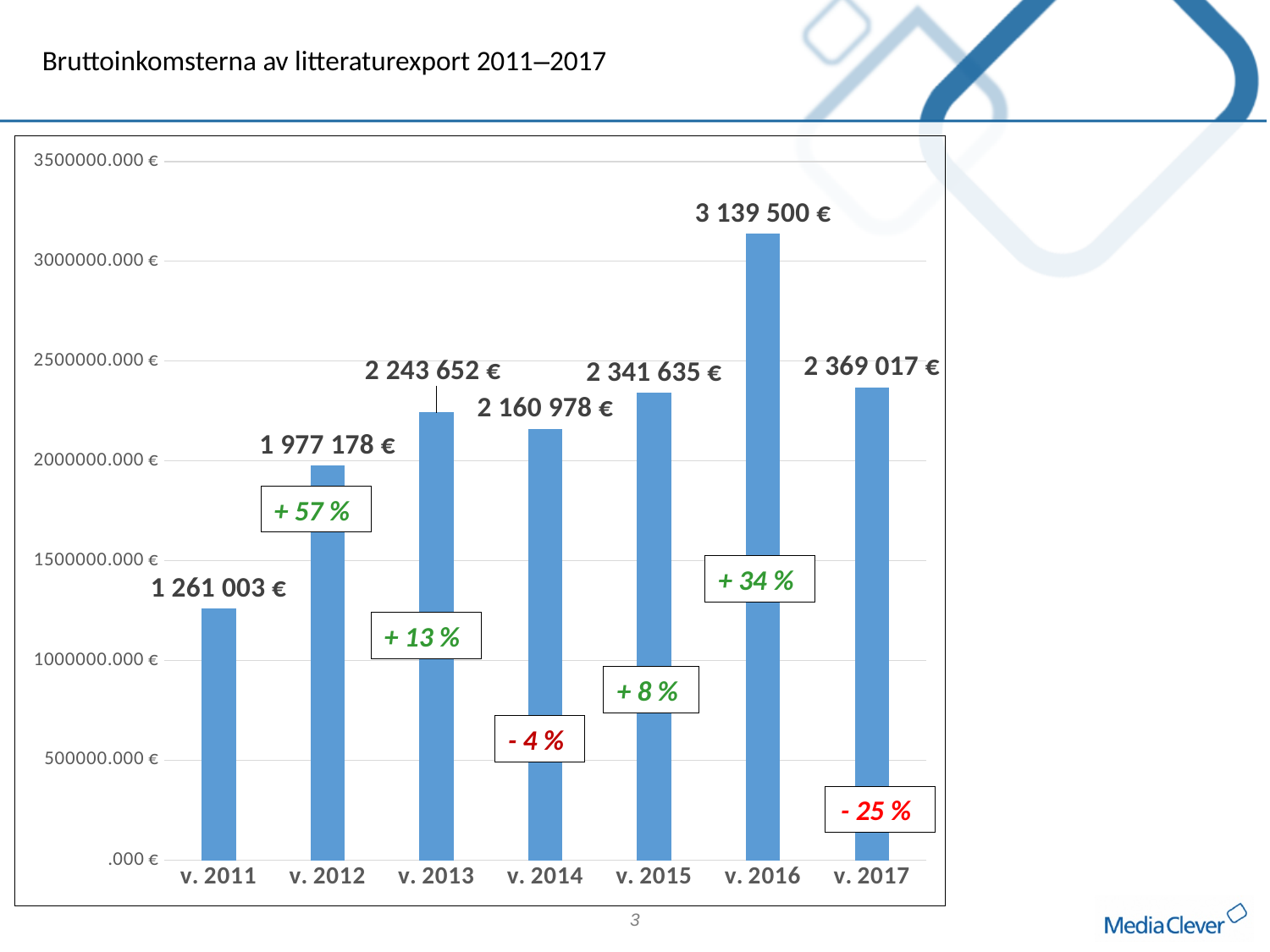
What kind of chart is shown on the slide? bar chart Is the value for v. 2015 greater or less than 2000000.000 €? greater Which year has the highest value? v. 2016 What percentage change is annotated between v. 2016 and v. 2017? - 25 % Which year has the lowest value? v. 2011 How many years are shown on the x axis? 7 Which is larger, the value for v. 2013 or the value for v. 2014? v. 2013 What is the difference between the values for v. 2016 and v. 2011? 1 878 497 € What is the difference between the values for v. 2016 and v. 2017? 770 483 € What is the value for v. 2014? 2 160 978 € What is the value for v. 2011? 1 261 003 € What is the value for v. 2016? 3 139 500 €